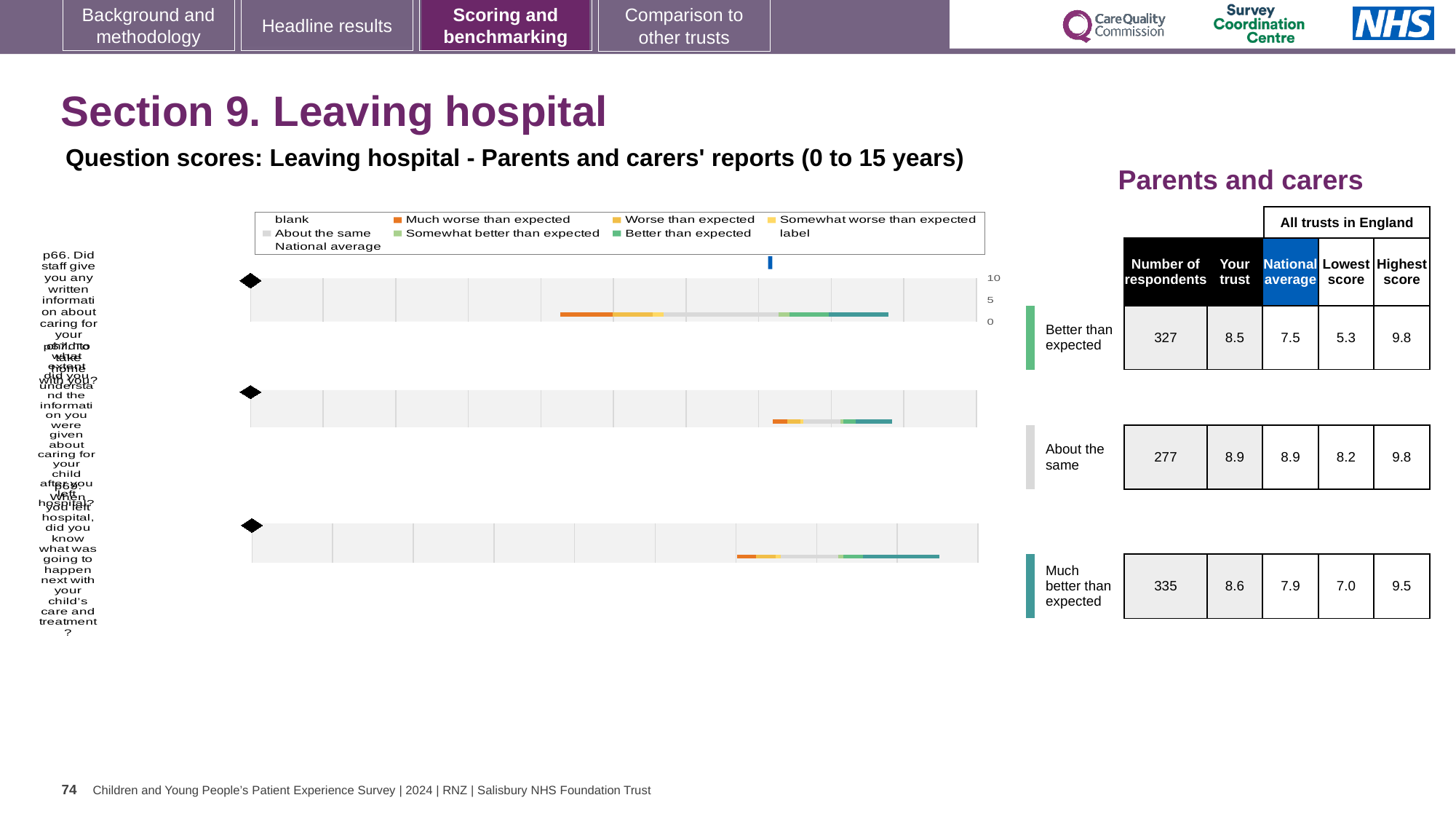
In the Parents and carers table, which row has the highest number of respondents? Much better than expected In the Parents and carers table, what is the lowest score for the row rated 'Better than expected'? 5.3 In the Parents and carers table, what is the highest score for the row rated 'Much better than expected'? 9.5 In the Parents and carers table, what is the 'Your trust' score for the row rated 'About the same'? 8.9 In the Parents and carers table, what is the national average for the row rated 'Much better than expected'? 7.9 In the Parents and carers table, which row has the lowest 'Your trust' score? Better than expected In the Parents and carers table, what is the difference between the 'Your trust' score and the national average for the row rated 'Better than expected'? 1.0 In the Parents and carers table, what is the number of respondents for the row rated 'Better than expected'? 327 What is the maximum value shown on the score axis of the first chart? 10 In the Parents and carers table, is the 'Your trust' score or the national average larger for the row rated 'Much better than expected'? Your trust What kind of chart is used to show the question scores on the left of the slide? bar chart How many question charts are shown on the left of the slide? 3